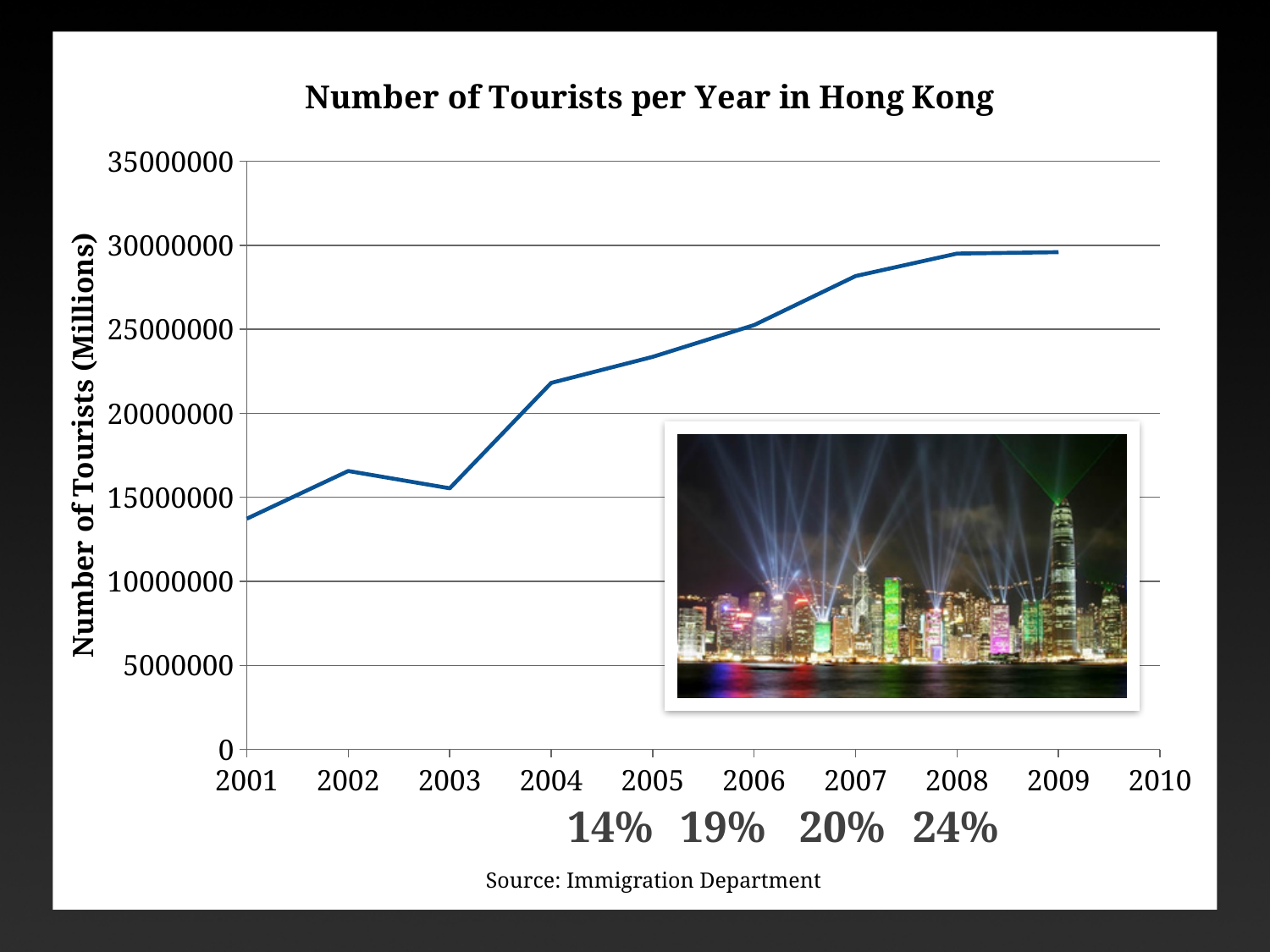
Does the number of tourists generally rise or fall from 2001 to 2009? rise Which year has the lowest number of tourists? 2001 What is the title of the chart? Number of Tourists per Year in Hong Kong Is the value for 2007 greater or less than 25000000? greater What kind of chart is shown on the slide? line chart Is the value for 2004 greater or less than 20000000? greater How many years have a plotted data point on the line? 9 What is the label on the vertical axis of the chart? Number of Tourists (Millions) Is the value for 2008 greater or less than 30000000? less Which year has more tourists, 2005 or 2007? 2007 Which year has more tourists, 2002 or 2003? 2002